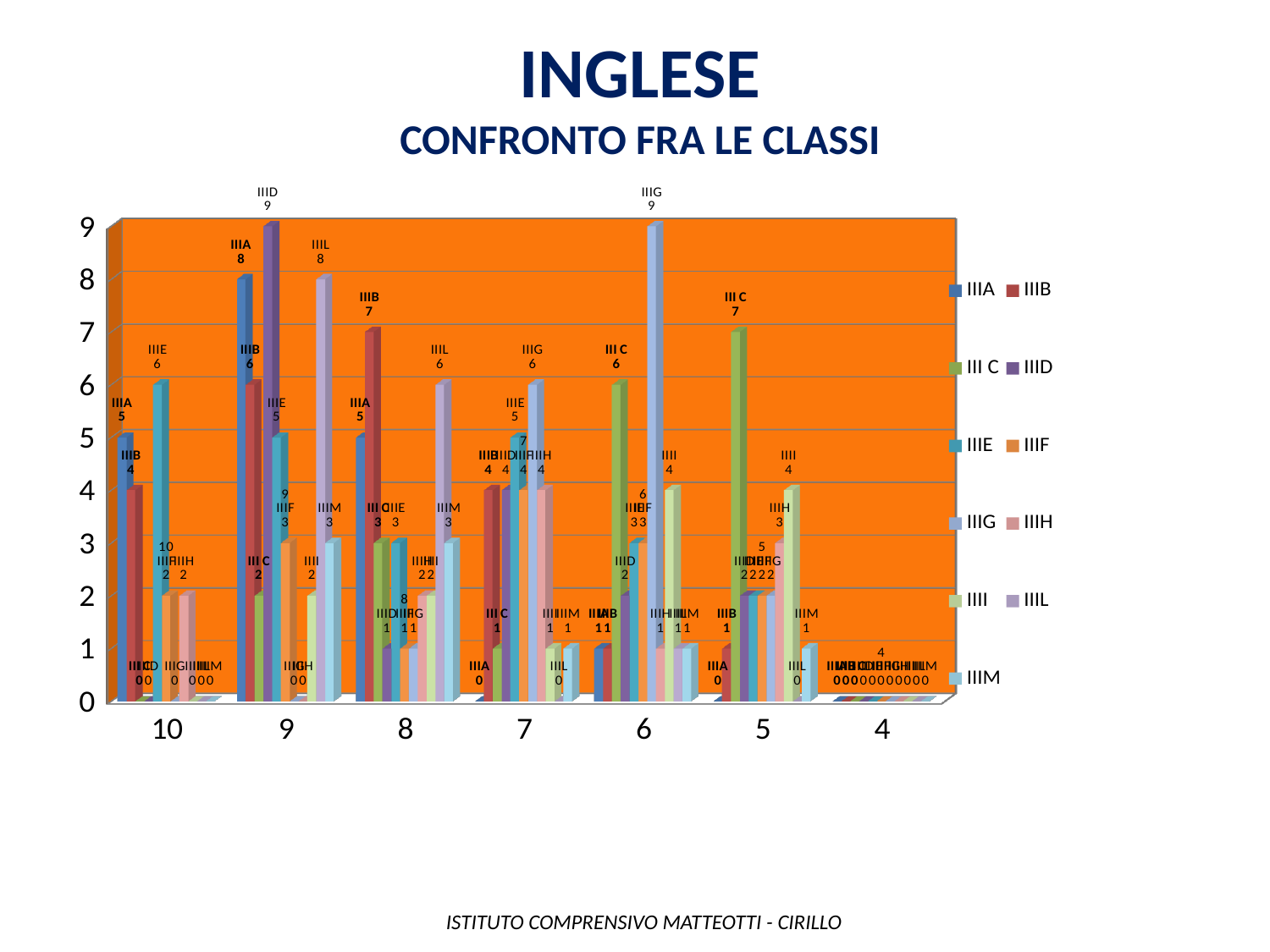
What is the main title of the chart? INGLESE What is the value for IIIA in category 9? 8 What kind of chart is shown on the slide? bar chart In category 10, which is larger: the value for IIIE or the value for IIIA? IIIE What is the value for IIID in category 9? 9 How many series does the legend list? 11 What is the value for III C in category 5? 7 Which class has the highest value in category 9? IIID What is the value for IIIG in category 6? 9 What is the difference between the values for IIIA and IIIB in category 9? 2 How many categories are shown on the x axis? 7 What is the value for IIIB in category 8? 7